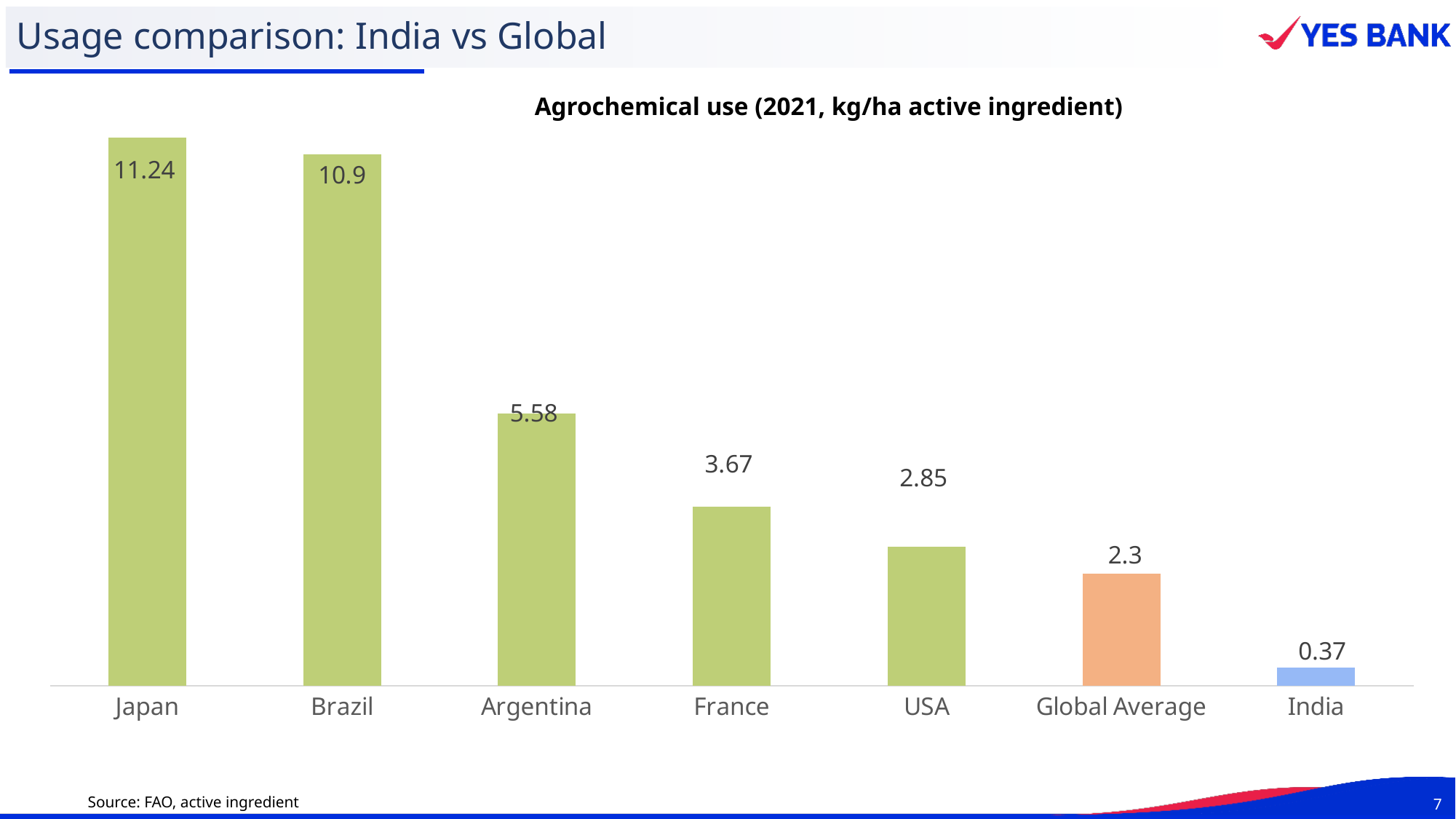
Which category has the lowest agrochemical use? India What is the agrochemical use value for Japan? 11.24 Which category has the highest agrochemical use? Japan What is the value shown for Global Average? 2.3 What kind of chart is shown on the slide? Bar chart Which is larger, the value for France or the value for USA? France What is the difference between the values for Japan and Brazil? 0.34 What is the value shown for Argentina? 5.58 What is the agrochemical use value for India? 0.37 How many categories are shown on the chart? 7 What is the title of the chart? Agrochemical use (2021, kg/ha active ingredient) What is the difference between the Global Average and India? 1.93